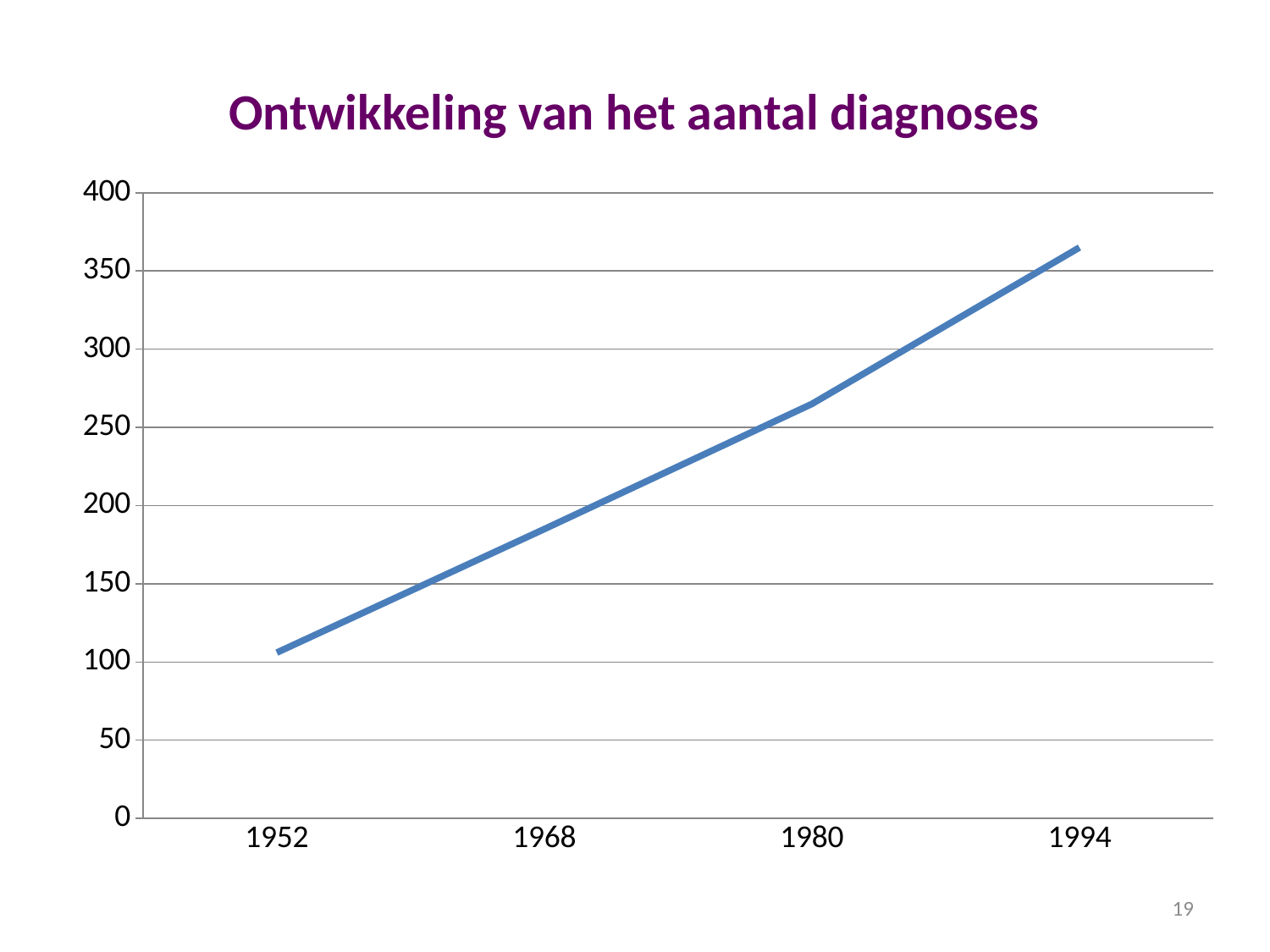
Which year has the highest value? 1994 Is the value for 1994 greater or less than 350? greater Is the value for 1952 greater or less than 150? less Which is larger, the value for 1980 or the value for 1968? 1980 Is the value for 1994 greater or less than 400? less Do the values rise or fall from 1952 to 1994? rise Which year has the lowest value? 1952 What is the title of the chart? Ontwikkeling van het aantal diagnoses How many years are plotted on the x axis? 4 What kind of chart is shown on the slide? line chart